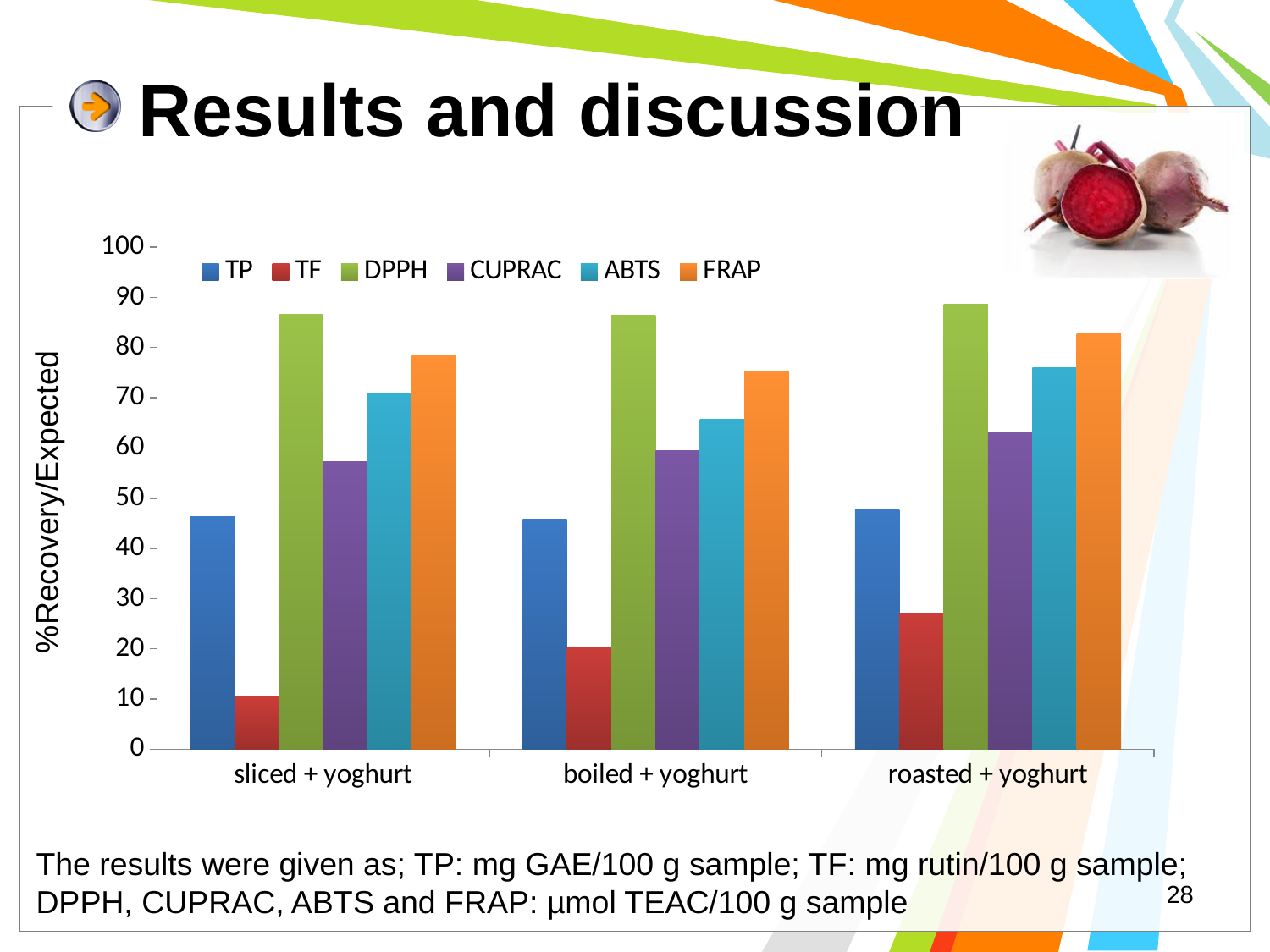
Do the TF values rise or fall from sliced + yoghurt to roasted + yoghurt? rise Which is larger for boiled + yoghurt, CUPRAC or ABTS? ABTS How many series does the legend list? 6 What is the label on the y axis? %Recovery/Expected Which series has the lowest value for roasted + yoghurt? TF Is the value for DPPH in boiled + yoghurt greater or less than 80? greater Is the value for TP in boiled + yoghurt greater or less than 50? less Which series has the highest value for sliced + yoghurt? DPPH Is the value for TF in sliced + yoghurt greater or less than 20? less Which is larger for sliced + yoghurt, FRAP or ABTS? FRAP How many categories are shown on the x axis? 3 What kind of chart is shown on the slide? bar chart